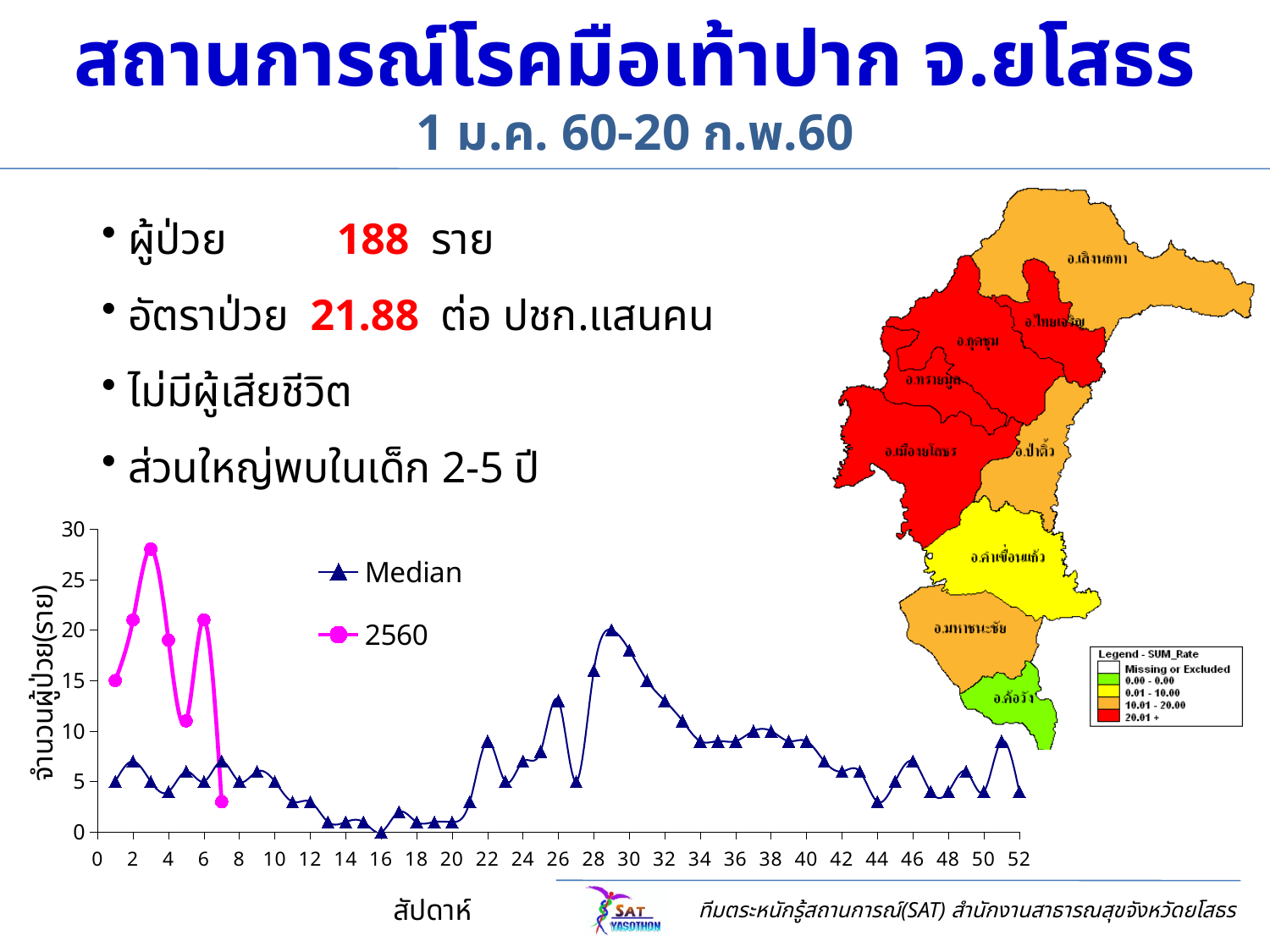
What is the label on the chart's vertical axis? จำนวนผู้ป่วย(ราย) At week 3, which series has the higher value, Median or 2560? 2560 Is the Median value at week 29 greater or less than 15? greater How many data points are plotted for the 2560 series? 7 What kind of chart is shown on the slide? line chart How many series does the chart legend list? 2 Is the 2560 value at week 3 greater or less than 25? greater Is the Median value at week 16 greater or less than 5? less What are the two series named in the chart legend? Median and 2560 In which week does the 2560 series reach its highest value? Week 3 In which week does the 2560 series have its lowest value? Week 7